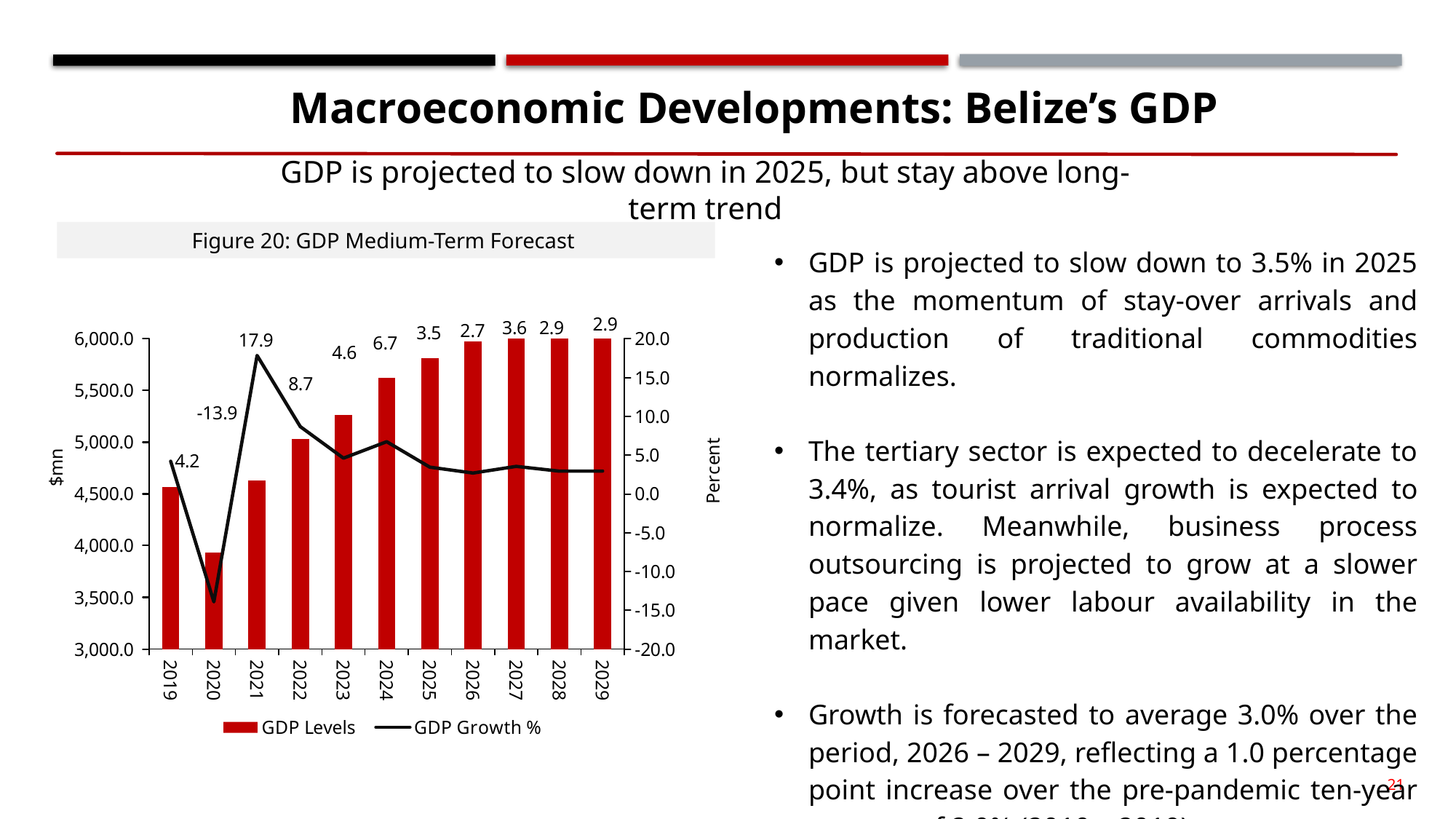
In Figure 20: GDP Medium-Term Forecast, which year has the highest GDP Growth %? 2021 In Figure 20: GDP Medium-Term Forecast, which year has the larger GDP Growth %, 2023 or 2024? 2024 In Figure 20: GDP Medium-Term Forecast, is the GDP Levels value for 2020 greater or less than 4,000.0? less In Figure 20: GDP Medium-Term Forecast, what is the GDP Growth % value for 2020? -13.9 In Figure 20: GDP Medium-Term Forecast, what is the difference between the GDP Growth % for 2021 and 2022? 9.2 In Figure 20: GDP Medium-Term Forecast, what is the GDP Growth % value for 2021? 17.9 How many series does the legend of Figure 20: GDP Medium-Term Forecast list? 2 In Figure 20: GDP Medium-Term Forecast, which year has the lowest GDP Growth %? 2020 In Figure 20: GDP Medium-Term Forecast, do the GDP Levels bars rise or fall from 2021 to 2029? rise In Figure 20: GDP Medium-Term Forecast, is the GDP Levels value for 2025 greater or less than 5,500.0? greater How many years are shown on the x axis of Figure 20: GDP Medium-Term Forecast? 11 In Figure 20: GDP Medium-Term Forecast, what is the GDP Growth % value for 2025? 3.5